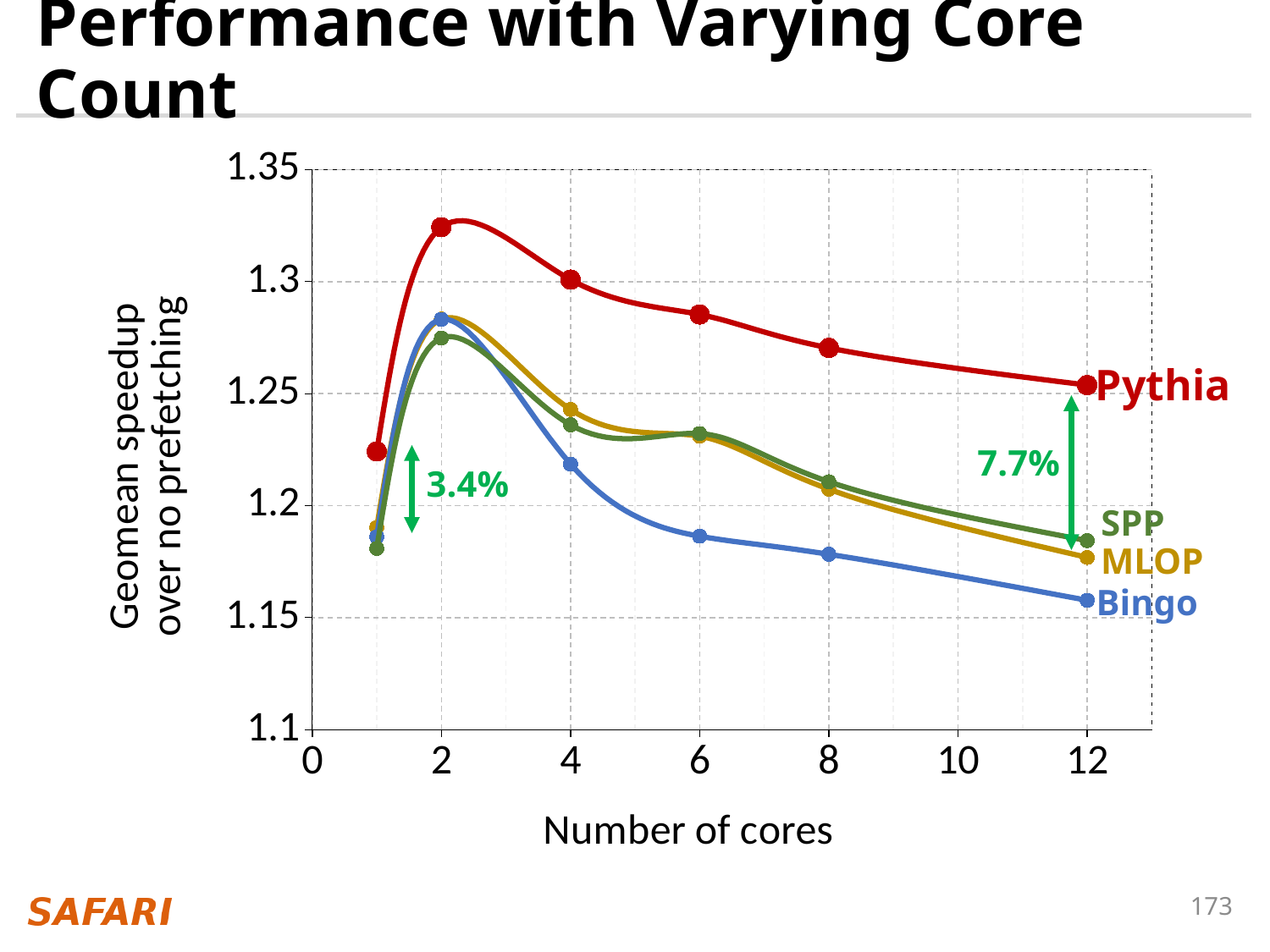
How does the geomean speedup for Pythia change as the number of cores increases from 2 to 12? it falls How many core-count data points are plotted for each series? 6 Which series has the lowest geomean speedup at 12 cores? Bingo How many series (prefetchers) are plotted on the chart? 4 What percentage improvement is annotated between Pythia and the next-best prefetcher at 12 cores? 7.7% At 4 cores, which has the larger geomean speedup, Pythia or Bingo? Pythia Which series has the highest geomean speedup at 2 cores? Pythia What kind of chart is shown on the slide? line chart Which series has the highest geomean speedup at 12 cores? Pythia Is the geomean speedup for Bingo at 6 cores greater or less than 1.2? less At 12 cores, which has the larger geomean speedup, SPP or Bingo? SPP Is the geomean speedup for Pythia at 2 cores greater or less than 1.3? greater